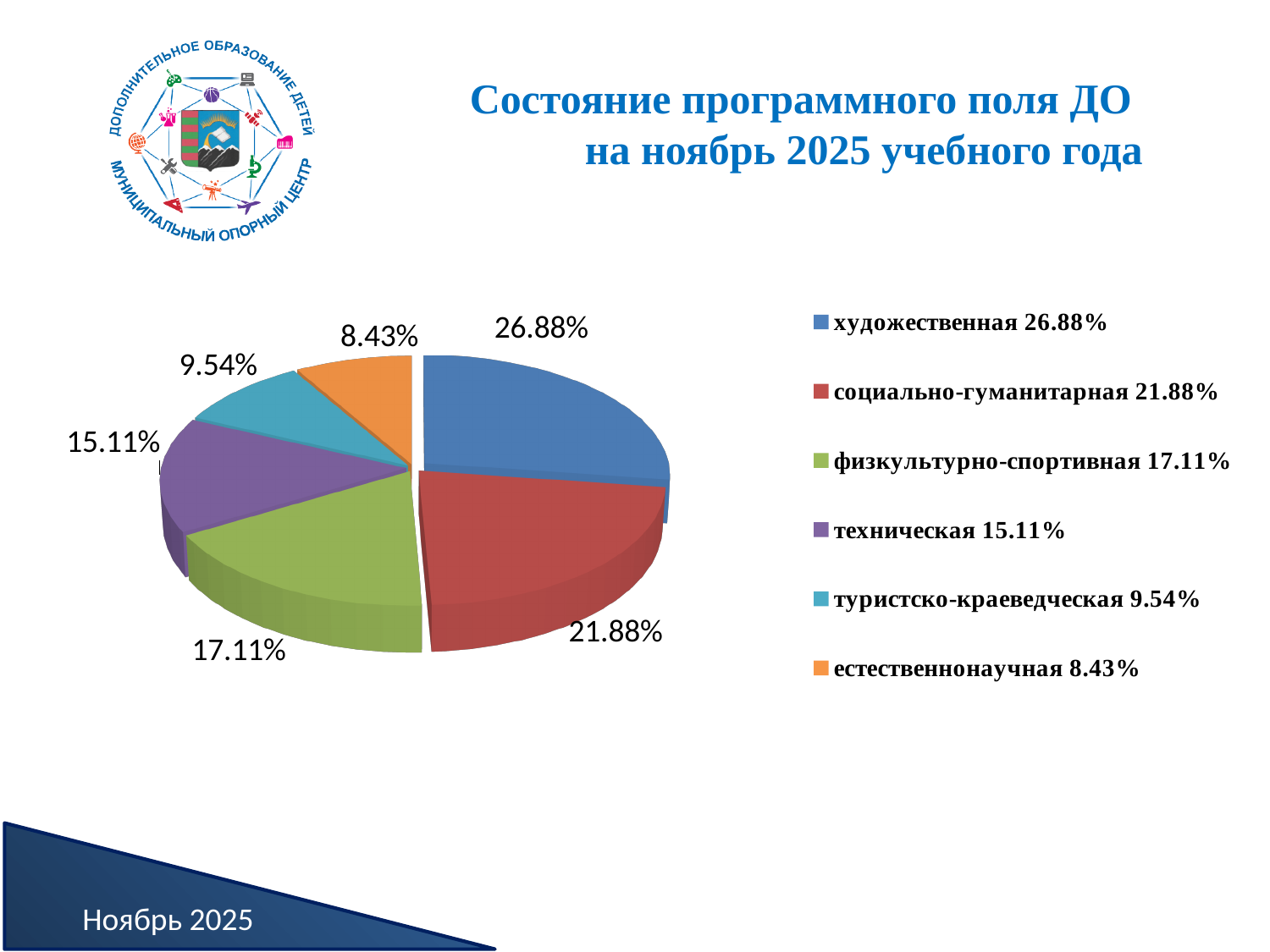
How many slices does the pie chart have? 6 What is the title of the slide containing the chart? Состояние программного поля ДО на ноябрь 2025 учебного года Which is larger, физкультурно-спортивная or техническая? физкультурно-спортивная What colour is the техническая slice? purple What is the value shown for туристско-краеведческая? 9.54% Which category has the largest slice of the pie? художественная What is the difference between the техническая and естественнонаучная shares? 6.68% What is the value shown for социально-гуманитарная? 21.88% Which category has the smallest slice of the pie? естественнонаучная What kind of chart is shown on the slide? pie chart What share of the pie does the художественная slice have? 26.88% What is the difference between the художественная and социально-гуманитарная shares? 5.00%